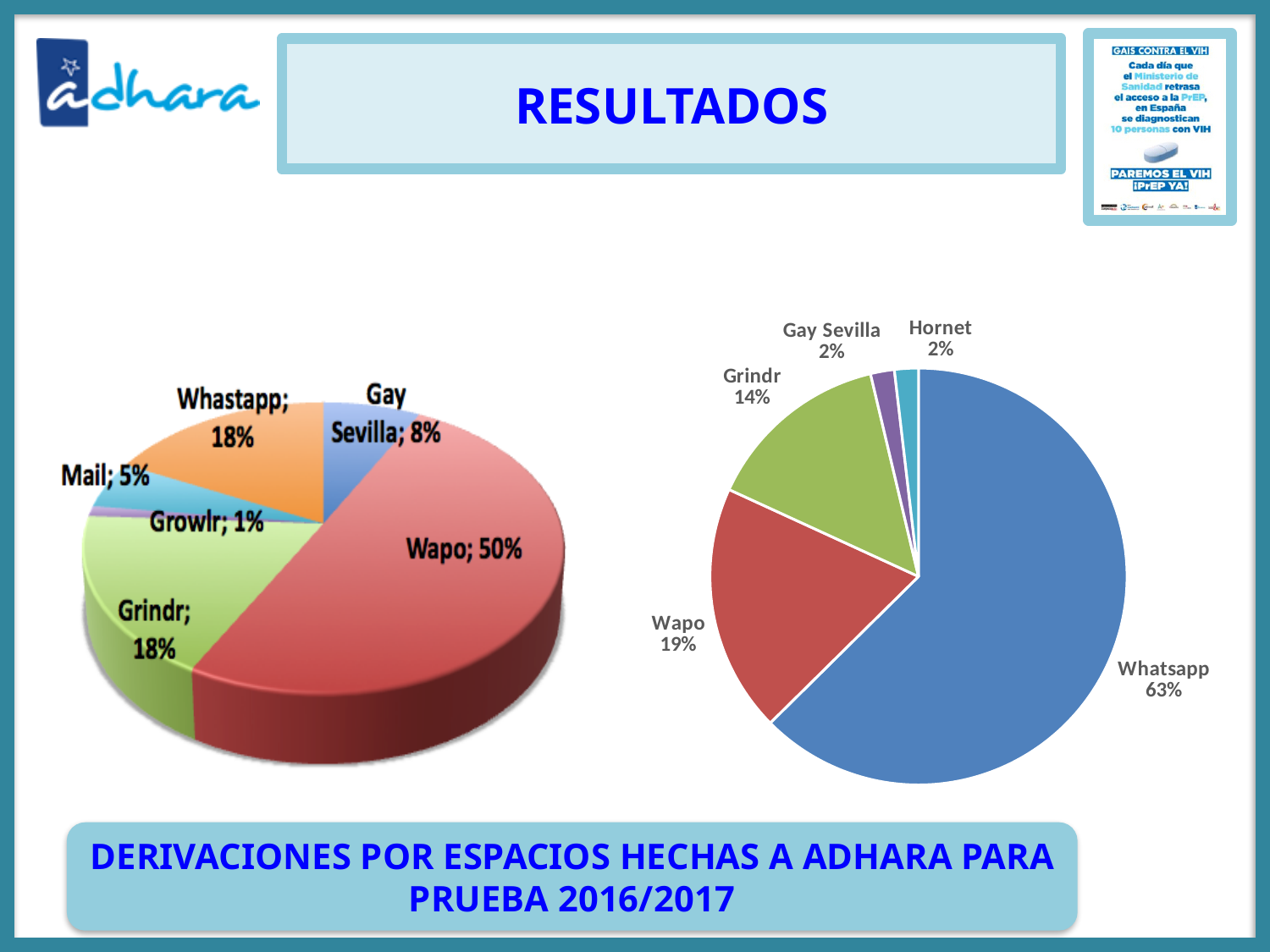
In the left pie chart, what is the value for Mail? 5% In the right pie chart, what is the value for Grindr? 14% In the left pie chart, which is larger, Gay Sevilla or Mail? Gay Sevilla In the right pie chart, which category has the largest share? Whatsapp In the left pie chart, which category has the smallest share? Growlr In the right pie chart, what is the difference between Whatsapp and Wapo? 44% In the left pie chart, which category has the largest share? Wapo In the left pie chart, what share does Wapo have? 50% In the left pie chart, what is the difference between Wapo and Grindr? 32% In the right pie chart, what share does Whatsapp have? 63% What type of chart is the left chart? Pie chart How many categories does the right pie chart show? 5